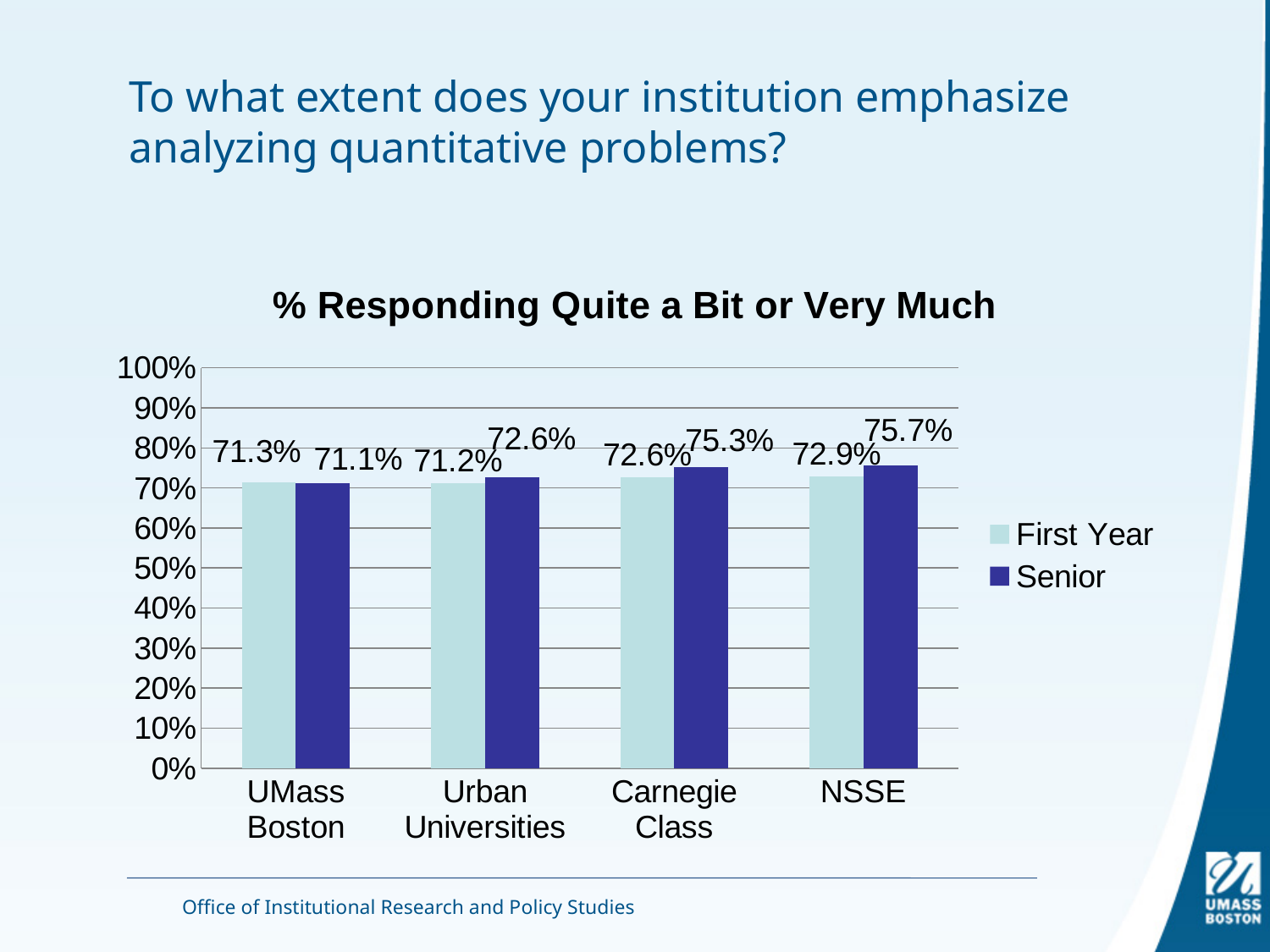
What is the First Year value for UMass Boston? 71.3% What is the Senior value for Urban Universities? 72.6% What is the First Year value for NSSE? 72.9% What is the Senior value for Carnegie Class? 75.3% Which category has the lowest Senior value? UMass Boston For NSSE, which is larger, the First Year value or the Senior value? Senior What is the title of the chart? % Responding Quite a Bit or Very Much What is the difference between the Senior and First Year values for Carnegie Class? 2.7% How many categories are shown on the x axis? 4 Which category has the highest Senior value? NSSE How many series does the legend list? 2 What kind of chart is shown on the slide? bar chart